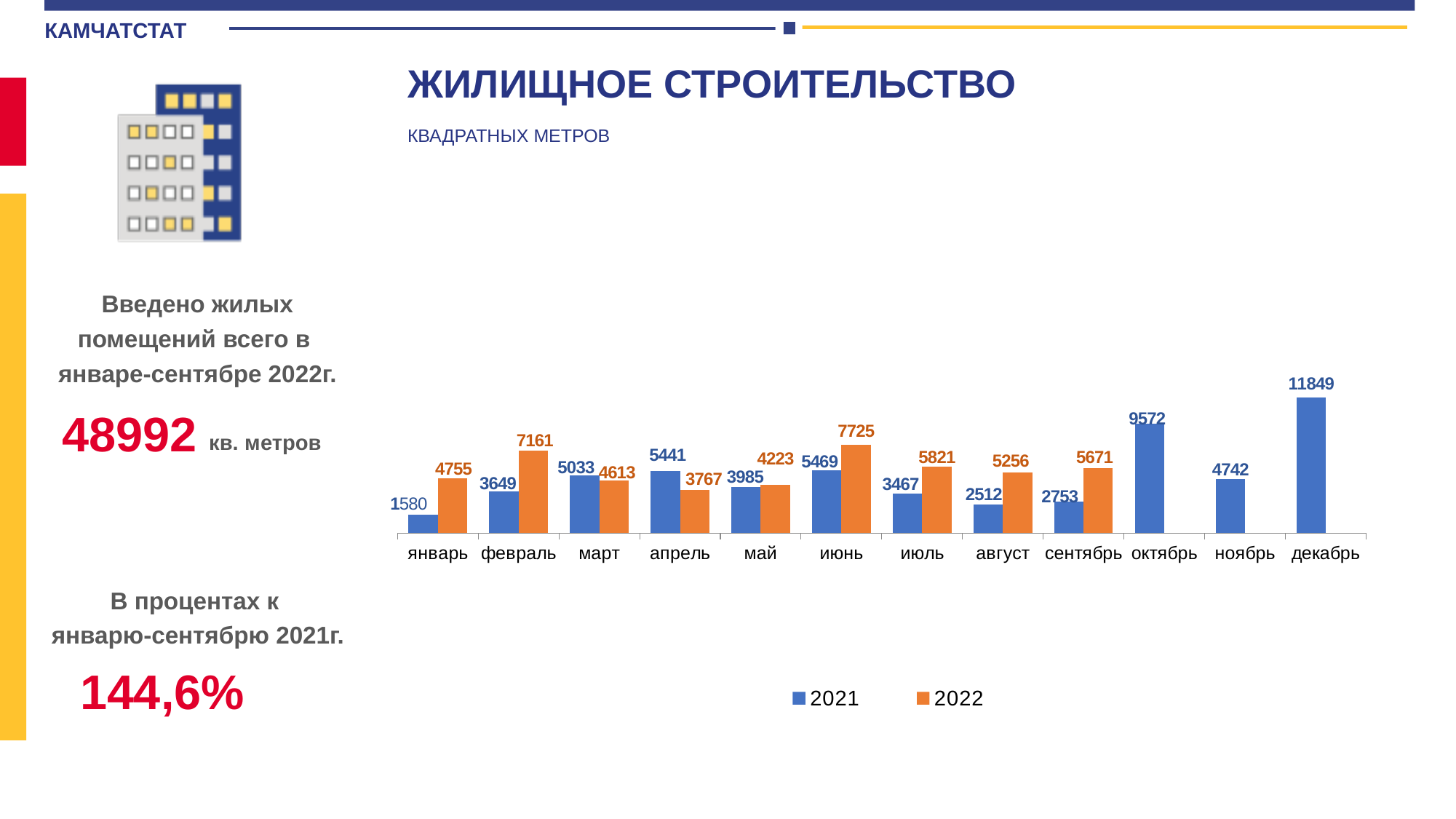
What is the difference between the 2022 and 2021 values in февраль? 3512 How many months have a value plotted for the 2022 series? 9 How many series does the chart legend list? 2 What is the value for 2021 in декабрь? 11849 Which is larger in март: the 2021 value or the 2022 value? 2021 What is the value for 2022 in июнь? 7725 Which month has the lowest value for the 2022 series? апрель What is the difference between the 2021 values for октябрь and ноябрь? 4830 Which month has the highest value for the 2021 series? декабрь What is the value for 2021 in январь? 1580 What type of chart is shown on the slide? bar chart Which colour represents the 2022 series in the chart? orange